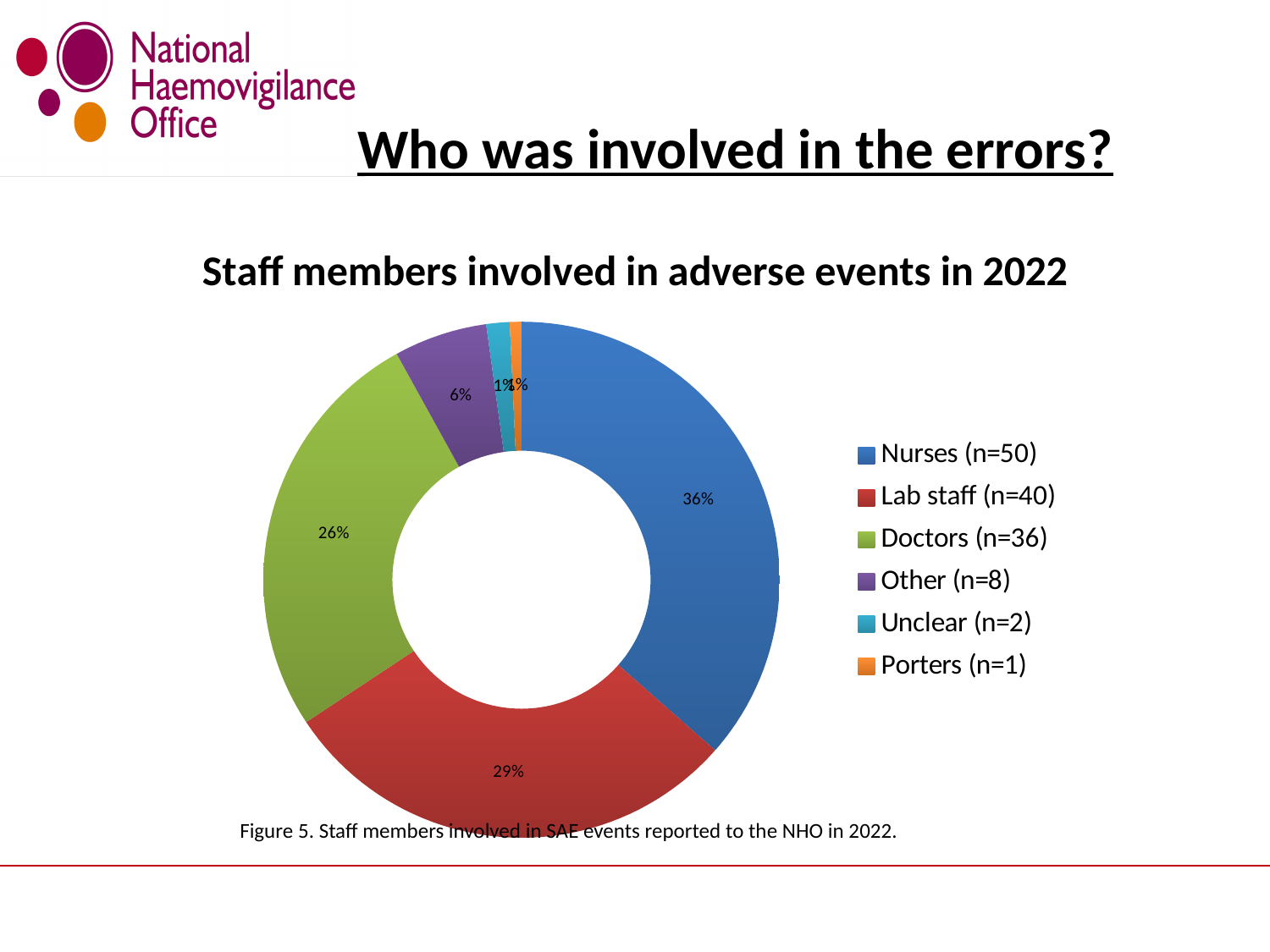
Which is larger, the share for Doctors or the share for Other? Doctors Which staff group accounts for the smallest share of the chart? Porters (n=1) What percentage is shown for Lab staff (n=40)? 29% What share of the doughnut chart is labelled for Nurses (n=50)? 36% What percentage is shown for Other (n=8)? 6% What percentage is shown for Doctors (n=36)? 26% What is the title of the chart? Staff members involved in adverse events in 2022 How many cases (n) are listed in the legend for Doctors? 36 How many staff categories does the legend list? 6 What type of chart is shown on the slide? Doughnut (pie) chart Which staff group accounts for the largest share of the chart? Nurses (n=50) What is the difference in percentage points between the Nurses share and the Lab staff share? 7